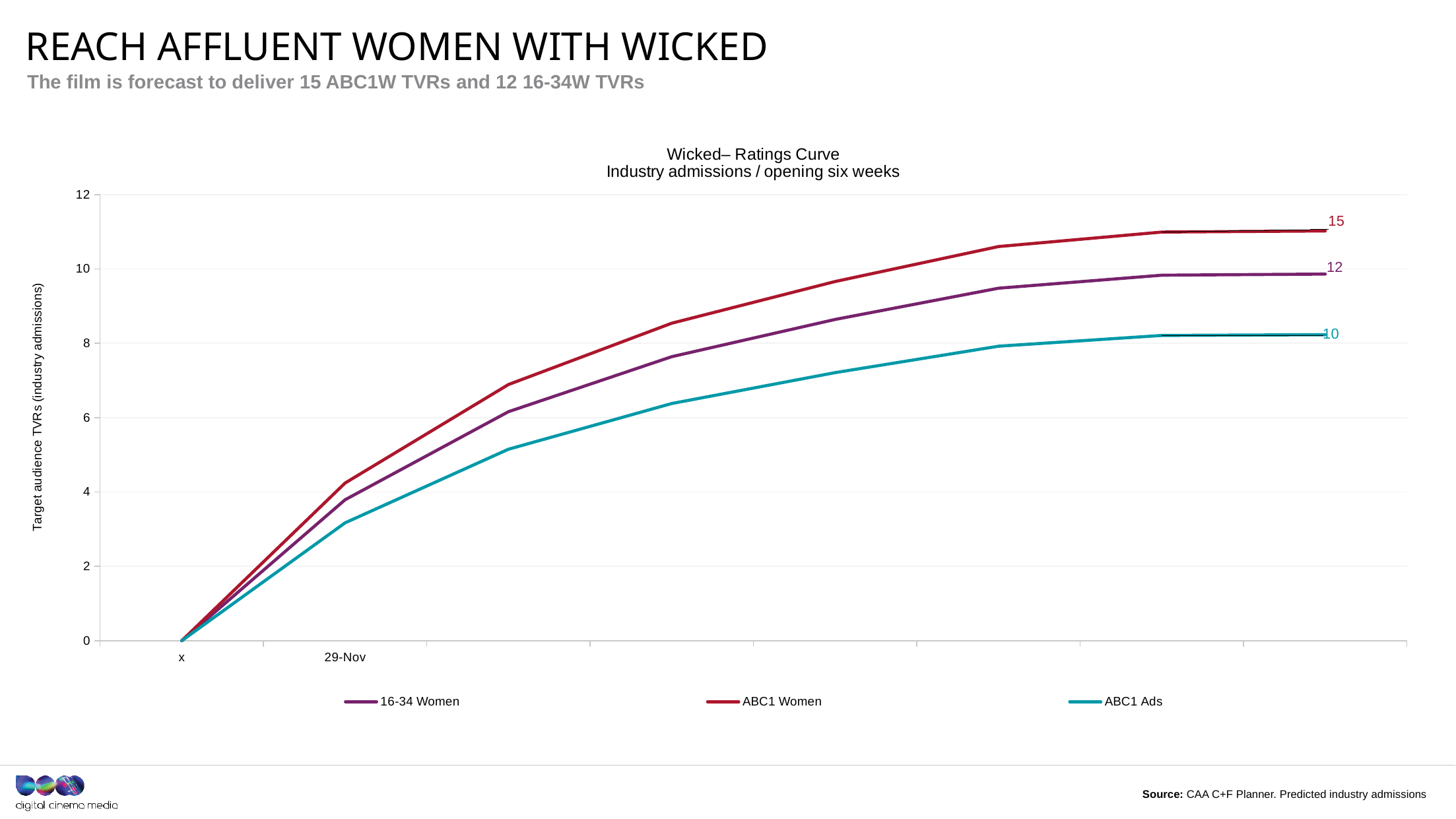
Which series has the highest labelled end value? ABC1 Women How many series does the legend list? 3 What type of chart is shown on the slide? line chart What are the three series named in the legend? 16-34 Women, ABC1 Women, ABC1 Ads Is the value for ABC1 Ads at 29-Nov greater or less than 4? less What is the value labelled at the end of the ABC1 Women line? 15 What is the value labelled at the end of the 16-34 Women line? 12 What is the difference between the labelled end values of ABC1 Women and 16-34 Women? 3 What is the value labelled at the end of the ABC1 Ads line? 10 Which series has the lowest labelled end value? ABC1 Ads Which series ends higher, ABC1 Women or ABC1 Ads? ABC1 Women Do the lines rise or fall from left to right along the x axis? rise